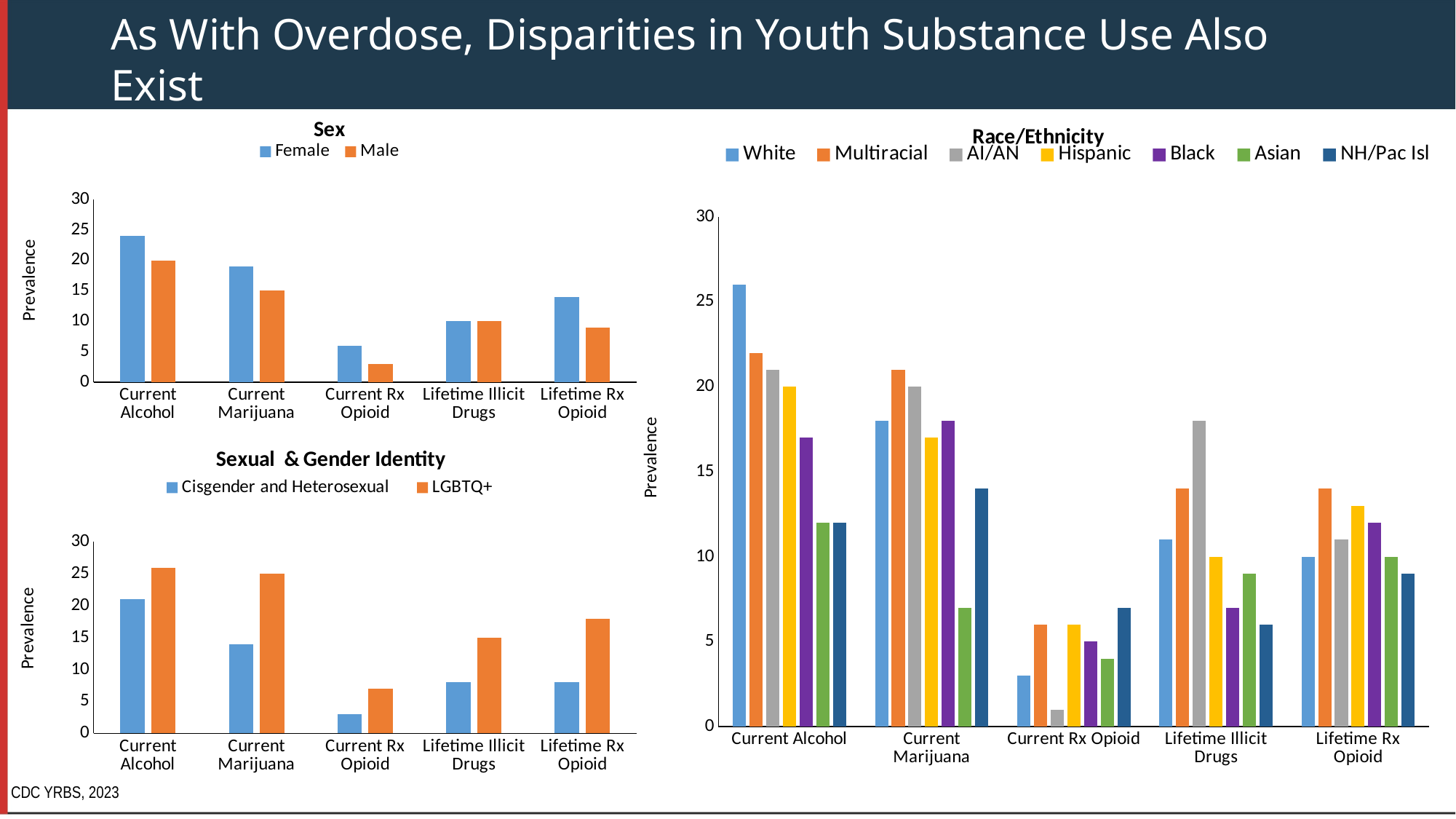
On the Sex chart, which is larger for Current Rx Opioid, Female or Male? Female On the Sex chart, how many substance-use categories are shown on the x axis? 5 On the Sex chart, is the Female value for Current Alcohol greater or less than 20? greater What kind of chart is the Race/Ethnicity chart? bar chart On the Sex chart, how many series does the legend list? 2 On the Race/Ethnicity chart, which group has the highest value for Lifetime Illicit Drugs? AI/AN On the Race/Ethnicity chart, which group has the lowest value for Current Rx Opioid? AI/AN On the Sexual & Gender Identity chart, which category has the lowest LGBTQ+ value? Current Rx Opioid On the Sexual & Gender Identity chart, is the LGBTQ+ value for Current Marijuana greater or less than 20? greater On the Race/Ethnicity chart, which group has the highest value for Current Alcohol? White On the Sexual & Gender Identity chart, which is larger for Lifetime Rx Opioid, Cisgender and Heterosexual or LGBTQ+? LGBTQ+ On the Race/Ethnicity chart, how many series does the legend list? 7